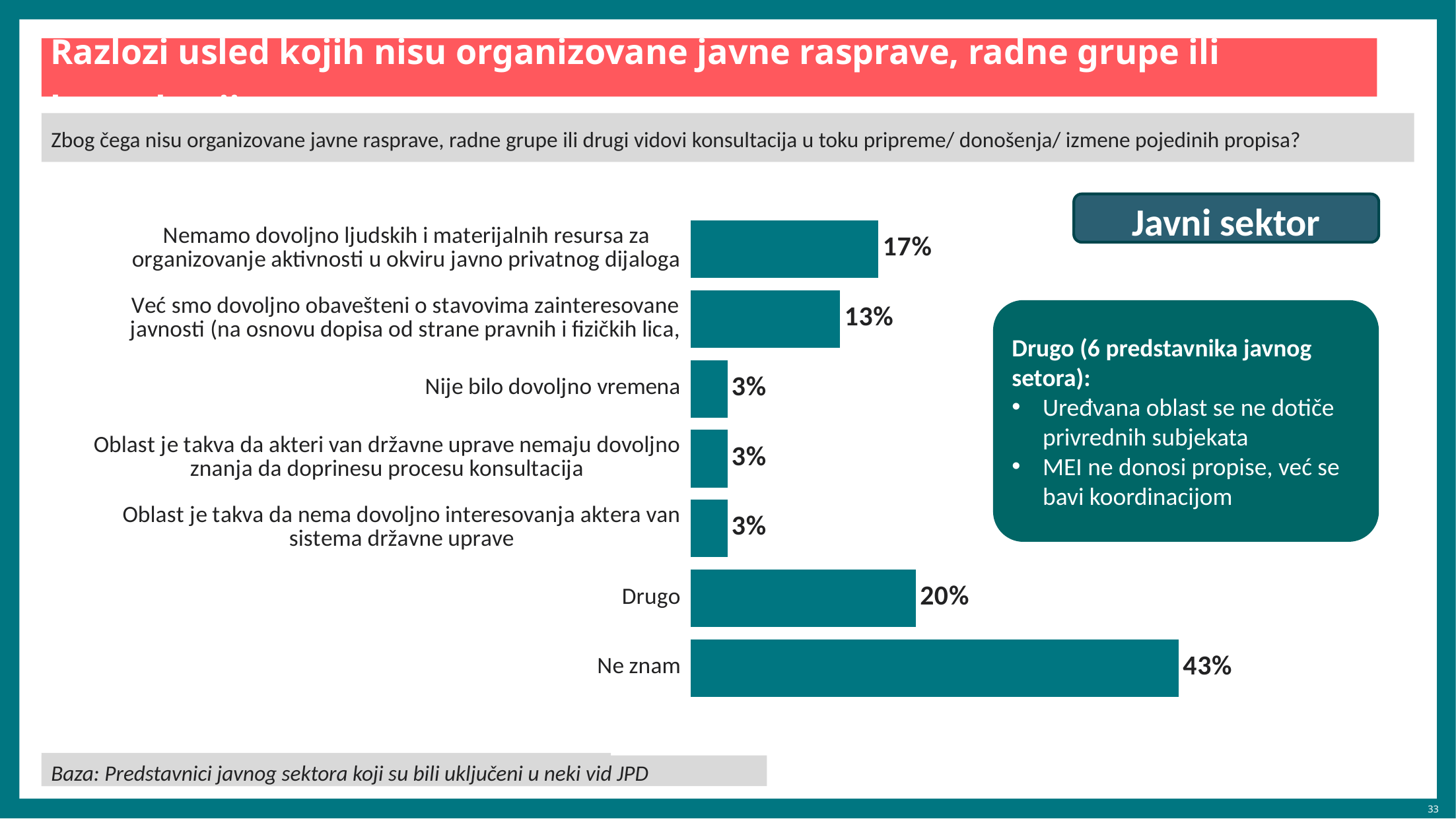
What sector label is shown in the box to the right of the chart? Javni sektor Which is larger, the value for "Drugo" or the value for "Već smo dovoljno obavešteni o stavovima zainteresovane javnosti..."? Drugo How many categories have a value of 3%? 3 What is the difference between the values for "Ne znam" and "Drugo"? 23% What kind of chart is shown on the slide? Bar chart What is the difference between the values for "Nemamo dovoljno ljudskih i materijalnih resursa..." and "Već smo dovoljno obavešteni o stavovima zainteresovane javnosti..."? 4% What is the value for "Drugo"? 20% What is the value for "Nemamo dovoljno ljudskih i materijalnih resursa za organizovanje aktivnosti u okviru javno privatnog dijaloga"? 17% How many categories are shown in the chart? 7 What is the value for "Ne znam"? 43% Which category has the highest value? Ne znam What is the value for "Nije bilo dovoljno vremena"? 3%